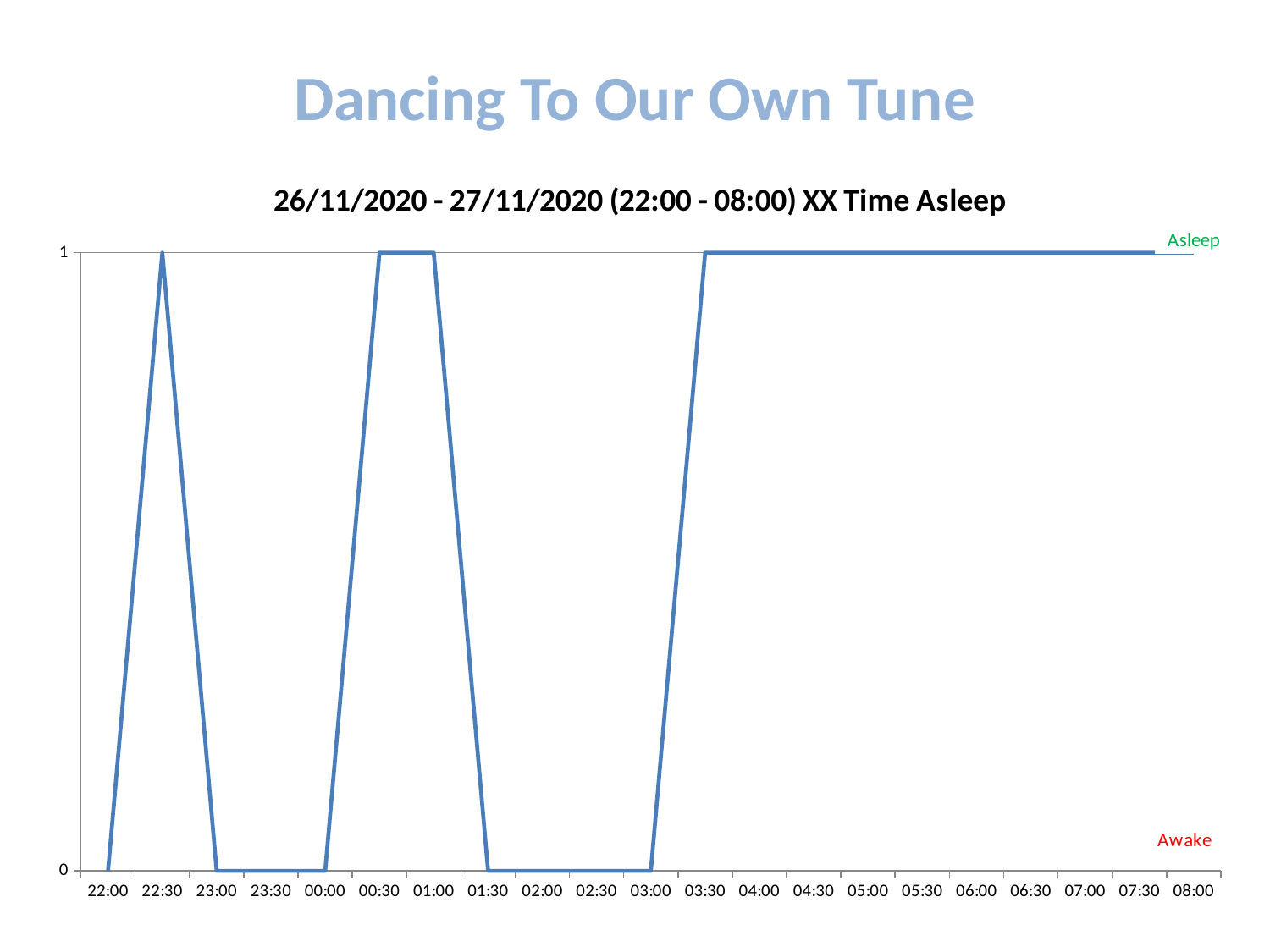
What is the value at 01:00? 1 What is the value at 23:30? 0 What is the title of the chart? 26/11/2020 - 27/11/2020 (22:00 - 08:00) XX Time Asleep Which is larger, the value at 00:30 or the value at 02:00? 00:30 What is the value at 22:30? 1 Does the line rise or fall between 01:00 and 01:30? Fall What is the value at 22:00? 0 What kind of chart is shown? Line chart What is the value at 02:30? 0 How many time points are labelled on the x axis? 21 What is the difference between the value at 03:30 and the value at 03:00? 1 What is the value at 06:00? 1